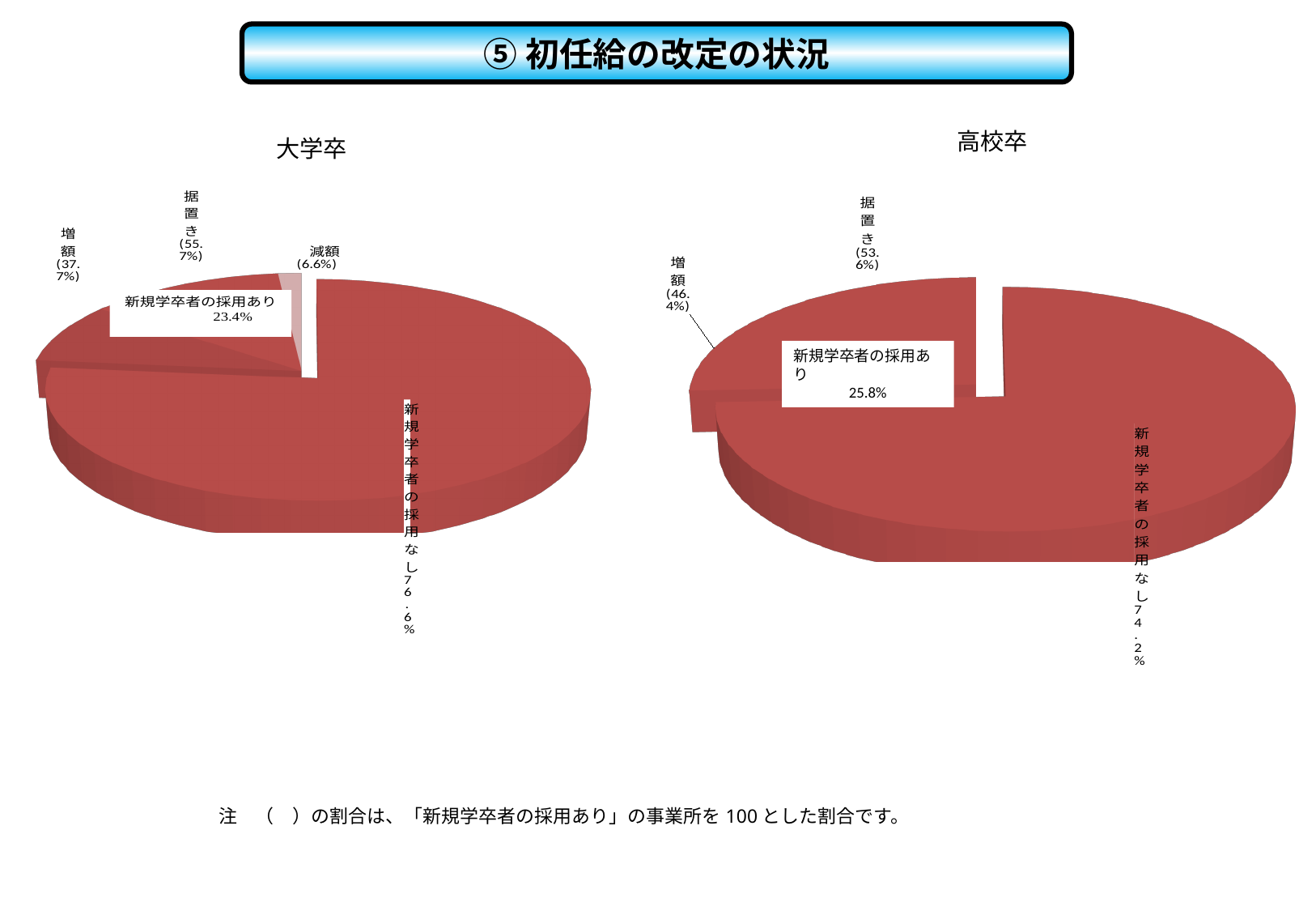
In the 高校卒 chart, what percentage is shown in parentheses for 据置き? 53.6% What is the title of the slide? ⑤ 初任給の改定の状況 In the 大学卒 chart, which is larger, 新規学卒者の採用あり or 新規学卒者の採用なし? 新規学卒者の採用なし In the 大学卒 chart, what is the value for 新規学卒者の採用あり? 23.4% In the 高校卒 chart, what is the value for 新規学卒者の採用なし? 74.2% What kind of chart is used for 大学卒 on the slide? pie chart In the 大学卒 chart, what is the value for 新規学卒者の採用なし? 76.6% In the 高校卒 chart, what is the value for 新規学卒者の採用あり? 25.8% What is the difference between the 新規学卒者の採用あり values in the 高校卒 chart and the 大学卒 chart? 2.4% In the 高校卒 chart, what percentage is shown in parentheses for 増額? 46.4% In the 大学卒 chart, what percentage is shown in parentheses for 減額? 6.6% In the 大学卒 chart, what percentage is shown in parentheses for 据置き? 55.7%